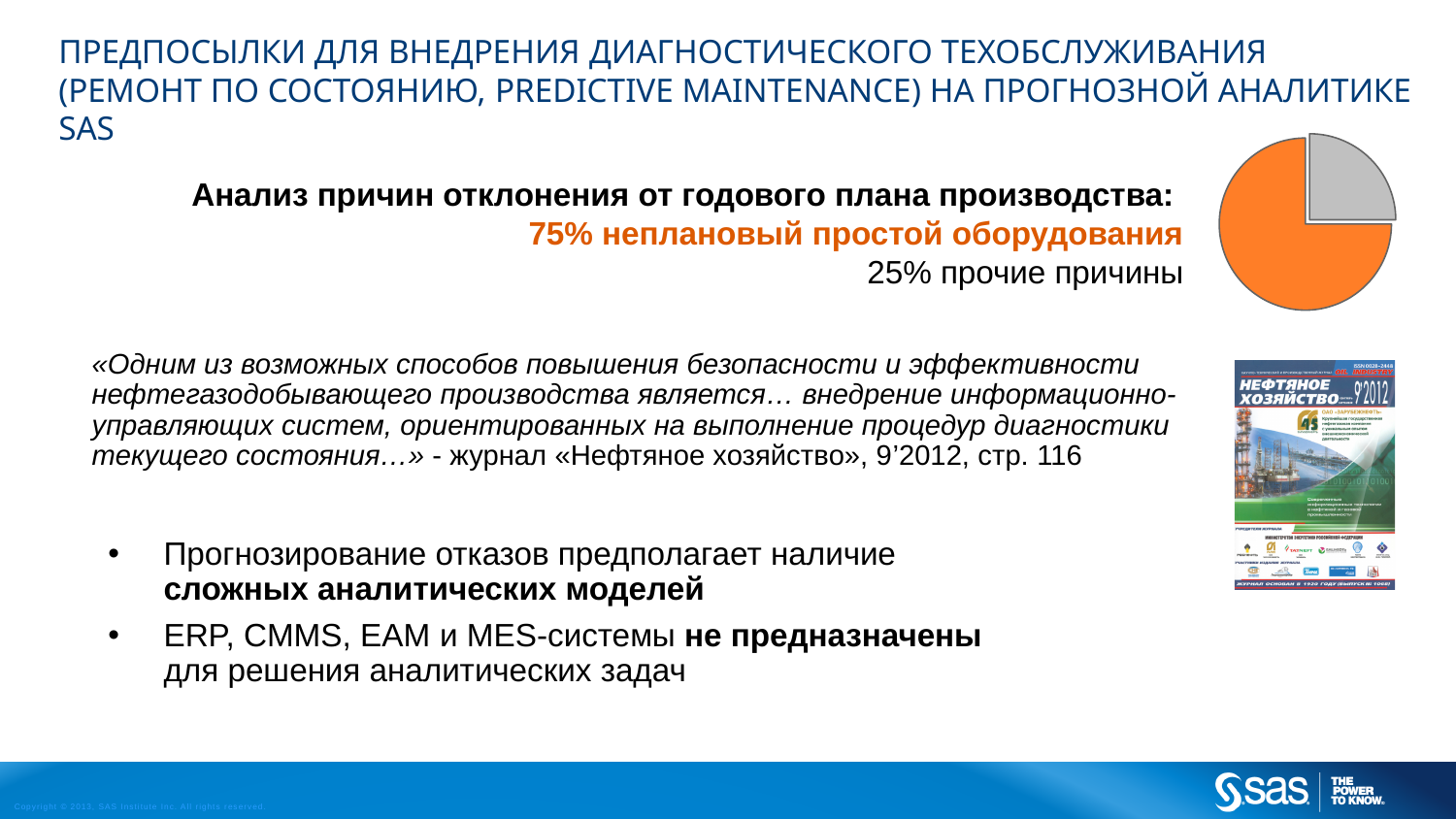
Is the share of other causes in the pie chart greater or less than 50%? less By how many percentage points does the share of unplanned equipment downtime exceed the share of other causes? 50 What do the two slices of the pie chart add up to? 100% What colour is the slice representing unplanned equipment downtime (75%)? orange What colour is the slice representing other causes (25%)? grey What share of the pie chart corresponds to other causes (прочие причины)? 25% Which cause accounts for the smallest slice of the pie chart? прочие причины Which is larger in the pie chart: the share of unplanned equipment downtime or the share of other causes? неплановый простой оборудования How many slices does the pie chart have? 2 What share of the pie chart corresponds to unplanned equipment downtime (неплановый простой оборудования)? 75% Which cause accounts for the largest slice of the pie chart? неплановый простой оборудования What kind of chart is shown on the slide? pie chart